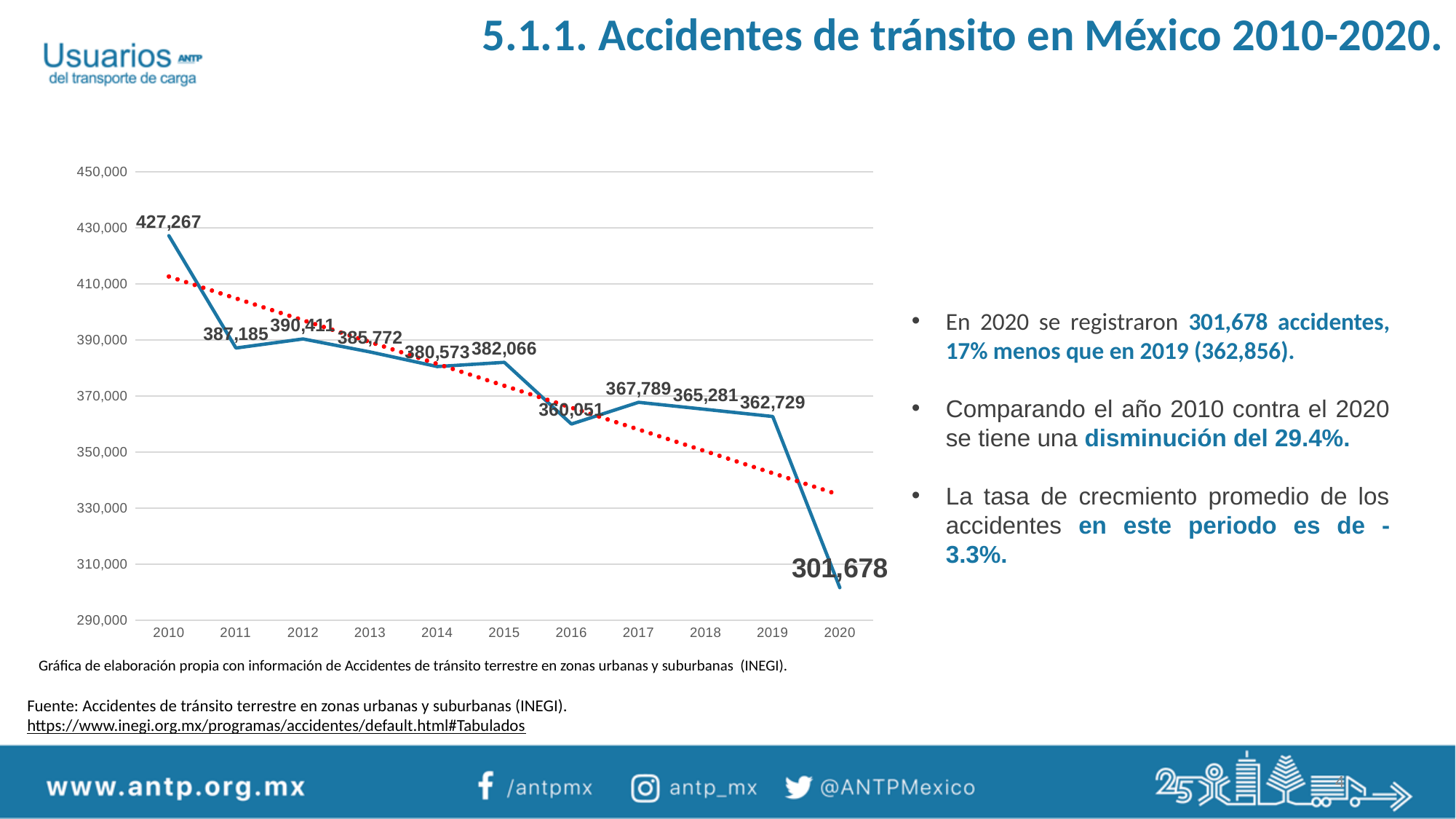
What value is shown for 2020? 301,678 What kind of chart is shown? Line chart Which year has the lowest value? 2020 What value is shown for 2016? 360,051 How many years are plotted on the x axis? 11 Which year has the highest value? 2010 Which is larger, the value for 2012 or the value for 2011? 2012 Do the values generally rise or fall from 2010 to 2020? Fall What value is shown for 2017? 367,789 What is the difference between the values for 2010 and 2020? 125,589 Is the value for 2019 greater or less than 350,000? greater What value is shown for 2010? 427,267